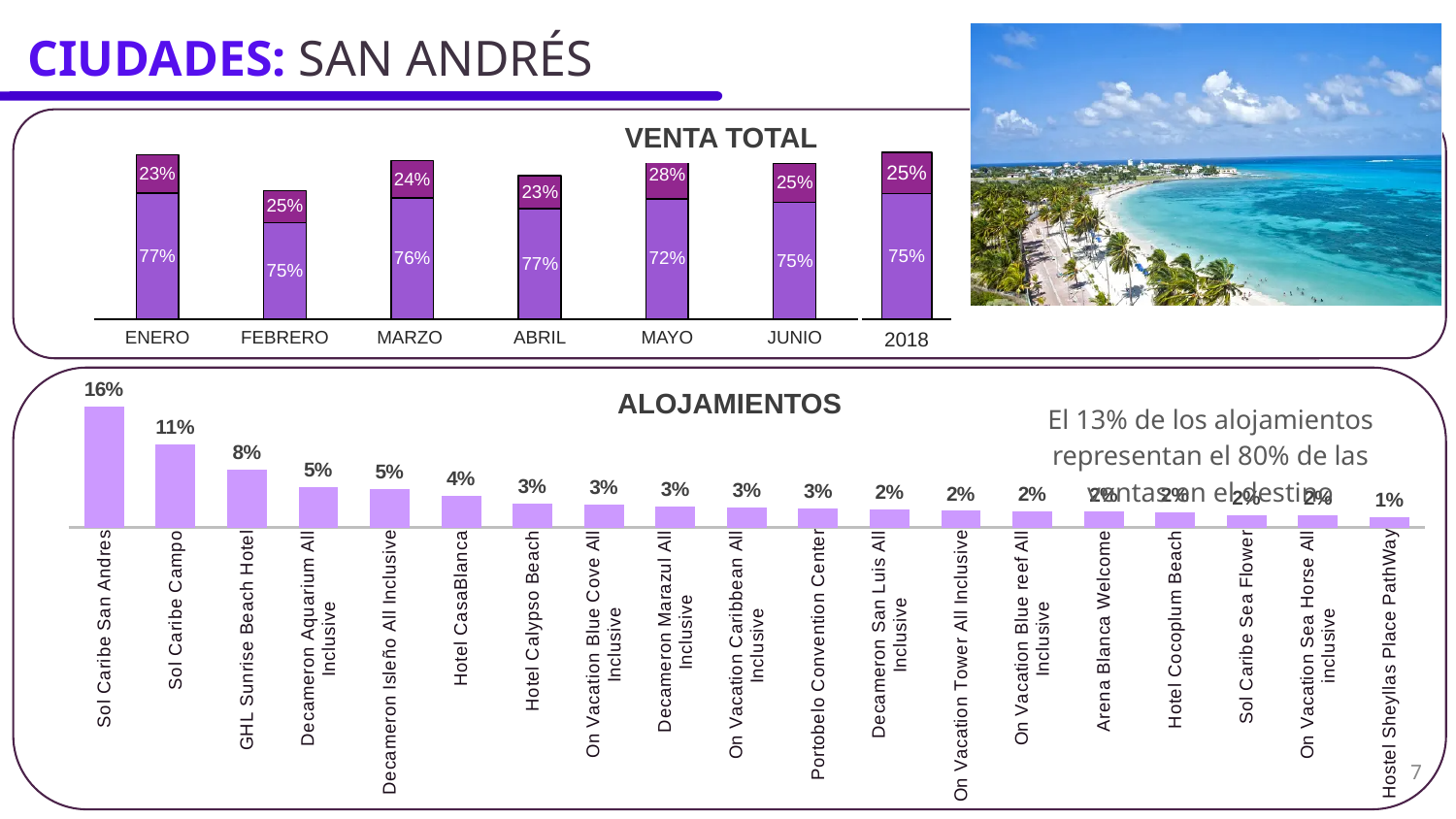
In the VENTA TOTAL chart, which month has the largest upper segment? MAYO In the ALOJAMIENTOS chart, what is the difference between Sol Caribe San Andres and Sol Caribe Campo? 5% In the VENTA TOTAL chart, what is the value of the upper segment for MAYO? 28% In the VENTA TOTAL chart, what is the value of the lower (purple) segment for MAYO? 72% In the VENTA TOTAL chart, what is the value of the lower segment for ENERO? 77% In the VENTA TOTAL chart, what is the total of the two segments for FEBRERO? 100% In the ALOJAMIENTOS chart, what is the value for GHL Sunrise Beach Hotel? 8% In the ALOJAMIENTOS chart, what is the value for Sol Caribe San Andres? 16% In the ALOJAMIENTOS chart, which is larger, Hotel CasaBlanca or Hotel Calypso Beach? Hotel CasaBlanca In the VENTA TOTAL chart, how many bars are plotted? 7 What kind of chart is the ALOJAMIENTOS chart? Bar chart In the ALOJAMIENTOS chart, which accommodation has the lowest value? Hostel Sheyllas Place PathWay